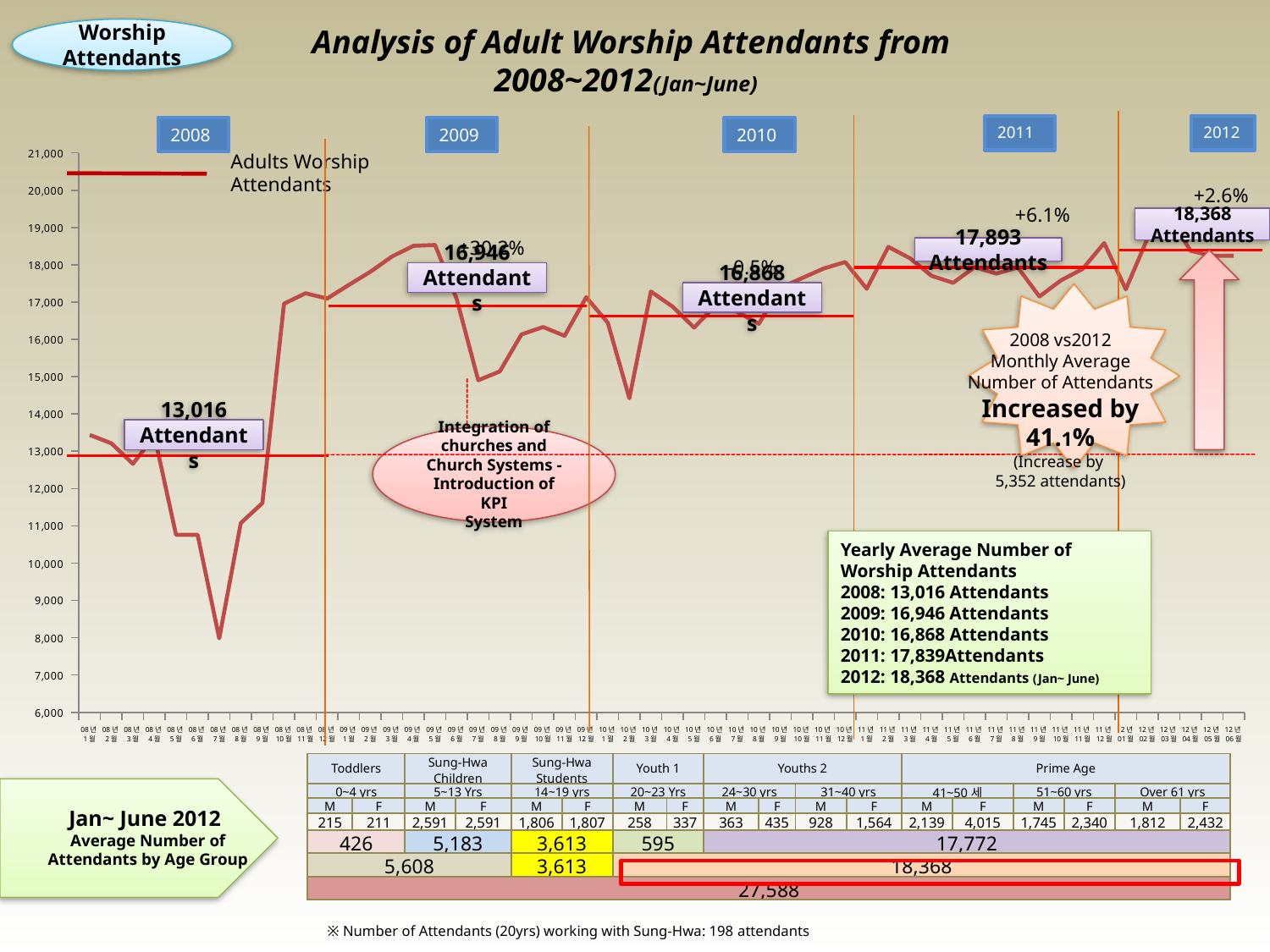
By how many attendants did the monthly average number increase from 2008 to 2012? 5,352 Which year has the highest average number of worship attendants? 2012 What was the yearly average number of worship attendants in 2008? 13,016 What kind of chart is used to show the adult worship attendants from 2008 to 2012? Line chart By what percentage did the monthly average number of attendants increase from 2008 to 2012? 41.1% Which year had the larger yearly average number of attendants, 2009 or 2010? 2009 Is the lowest monthly value plotted in 2008 greater or less than 9,000? less What was the average number of worship attendants for Jan~June 2012? 18,368 What was the yearly average number of worship attendants in 2009? 16,946 Which year has the lowest yearly average number of worship attendants? 2008 What was the yearly average number of worship attendants in 2010? 16,868 What is the title of the chart on the slide? Analysis of Adult Worship Attendants from 2008~2012 (Jan~June)